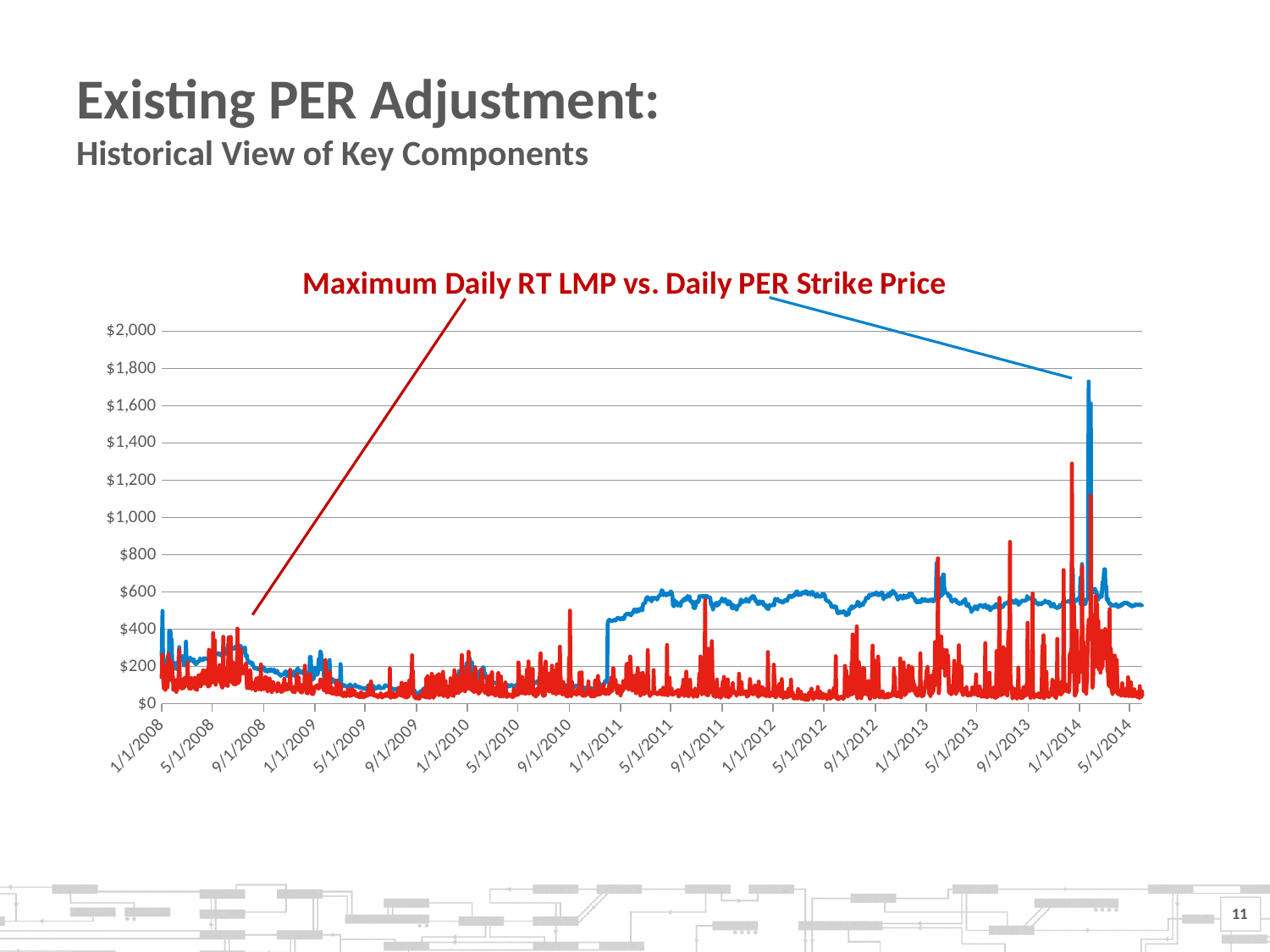
Does the Daily PER Strike Price series rise or fall between 9/1/2008 and 5/1/2009? fall What is the highest value shown on the y axis? $2,000 Is the Daily PER Strike Price around 5/1/2012 greater or less than $400? greater How many date labels are shown along the x axis? 20 Is the peak value of the Daily PER Strike Price series in early 2014 greater or less than $1,600? greater Which colour is used for the Daily PER Strike Price series? blue What is the title of the chart? Maximum Daily RT LMP vs. Daily PER Strike Price Around 1/1/2011, does the Daily PER Strike Price series jump up or drop down? jump up Is the highest spike of the Maximum Daily RT LMP series near 1/1/2014 greater or less than $1,200? greater What kind of chart is shown on the slide? line chart Which series reaches the highest peak in the chart, Maximum Daily RT LMP or Daily PER Strike Price? Daily PER Strike Price How many data series are plotted in the chart? 2